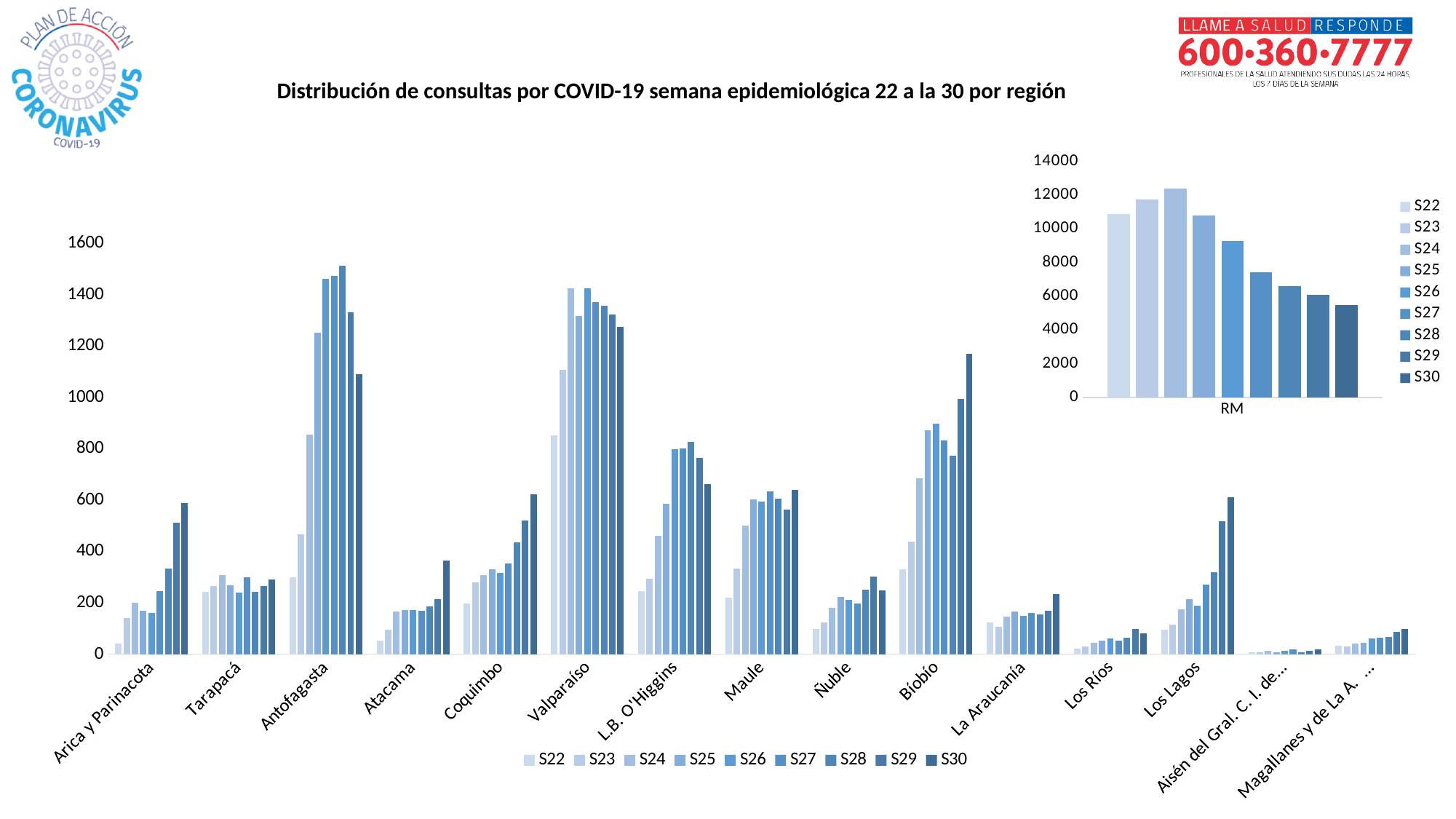
In the main chart, is the S30 value for Atacama greater or less than 400? less In the main chart, is the S30 value for Biobío greater or less than 1000? greater In the inset chart on the right (RM), do the values rise or fall from S24 to S30? fall In the main chart, is the S29 value for Antofagasta greater or less than 1400? less In the main chart, how many regions are shown on the x axis? 15 In the main chart, which is larger for S30: Maule or Ñuble? Maule In the main chart, which region has the tallest bar overall? Antofagasta In the inset chart on the right (RM), which series has the highest bar? S24 What kind of chart is the main chart titled 'Distribución de consultas por COVID-19 semana epidemiológica 22 a la 30 por región'? bar chart In the main chart, how many series does the legend list? 9 In the inset chart on the right (RM), which series has the lowest bar? S30